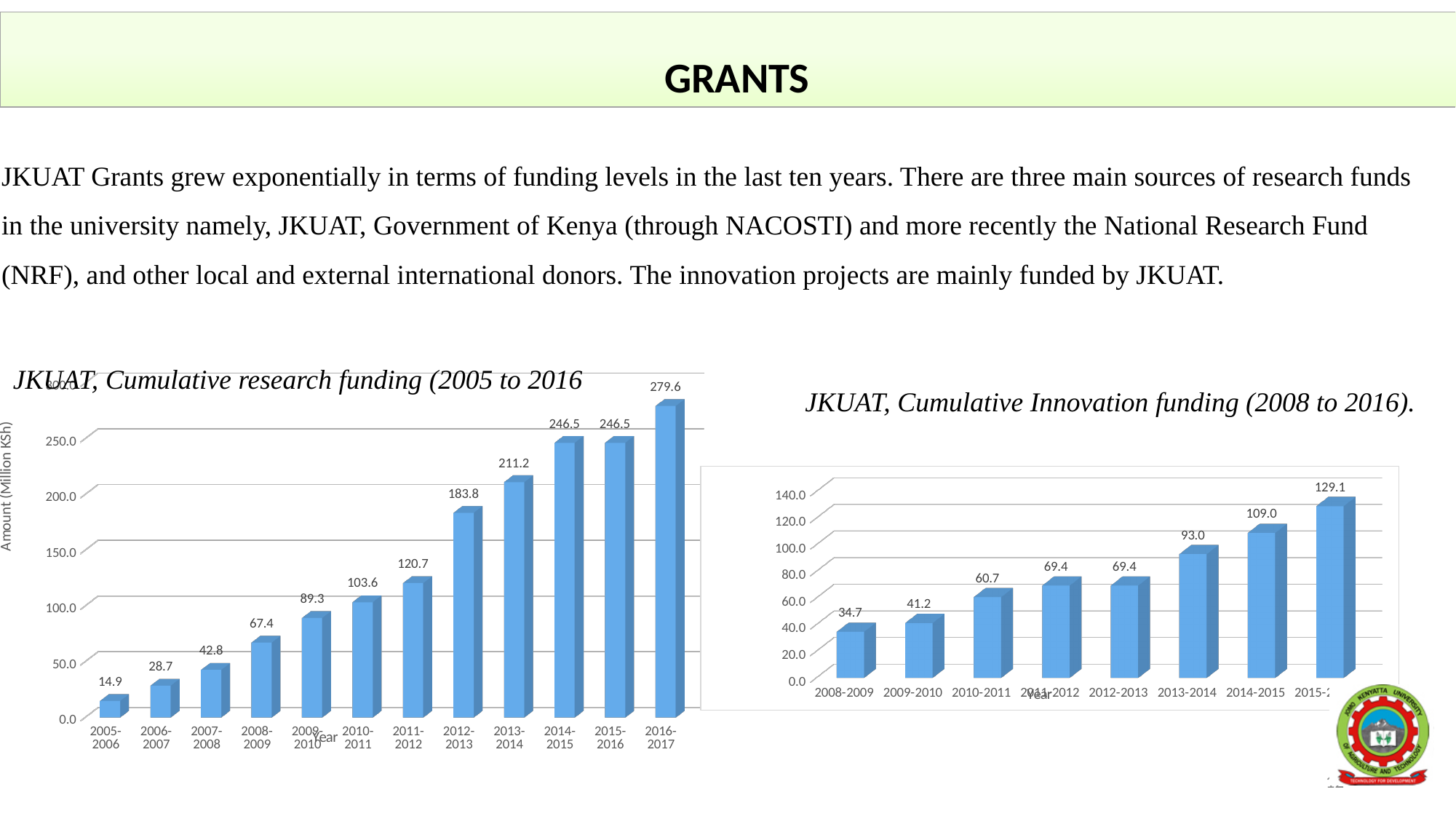
In the JKUAT Cumulative Innovation funding chart, how many years are plotted? 8 In the JKUAT Cumulative research funding chart, which year has the highest value? 2016-2017 What kind of chart is the JKUAT Cumulative Innovation funding chart? bar chart In the JKUAT Cumulative Innovation funding chart, what is the value for 2013-2014? 93.0 In the JKUAT Cumulative research funding chart, how many years are plotted? 12 In the JKUAT Cumulative Innovation funding chart, what is the value for 2008-2009? 34.7 In the JKUAT Cumulative research funding chart, what is the value for 2012-2013? 183.8 In the JKUAT Cumulative research funding chart, do the values generally rise or fall from 2005-2006 to 2016-2017? rise In the JKUAT Cumulative research funding chart, what is the value for 2005-2006? 14.9 In the JKUAT Cumulative Innovation funding chart, which year has the lowest value? 2008-2009 In the JKUAT Cumulative Innovation funding chart, what is the difference between the values for 2014-2015 and 2013-2014? 16.0 In the JKUAT Cumulative research funding chart, what is the difference between the values for 2016-2017 and 2015-2016? 33.1